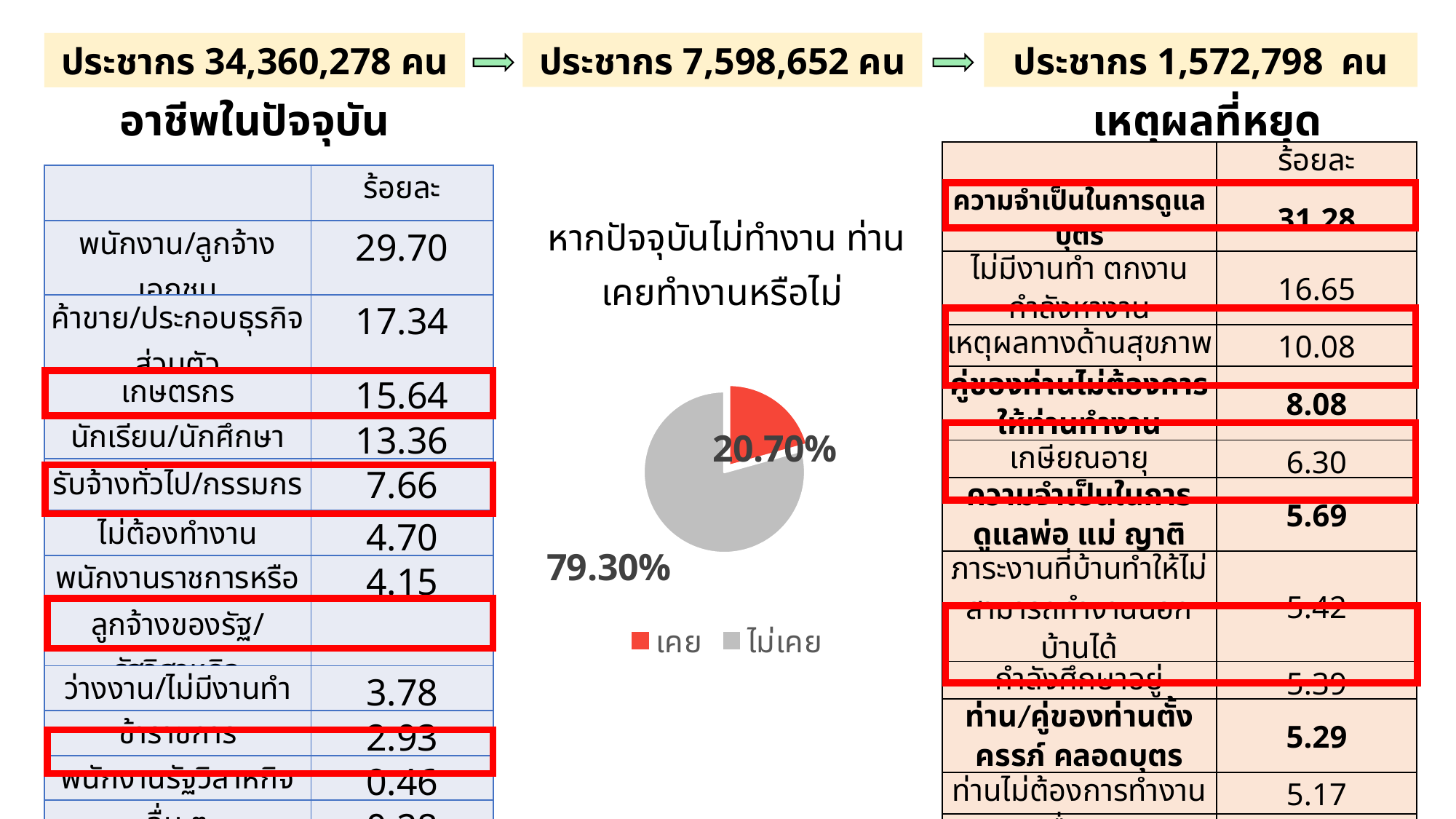
What colour is the เคย slice in the pie chart? red In the pie chart, which is larger, เคย or ไม่เคย? ไม่เคย How many entries does the pie chart's legend list? 2 In the pie chart, what percentage is shown for ไม่เคย? 79.30% In the pie chart, what is the difference between the ไม่เคย share and the เคย share? 58.60% How many slices does the pie chart have? 2 Which slice of the pie chart is the largest? ไม่เคย What is the title shown above the pie chart? หากปัจจุบันไม่ทำงาน ท่านเคยทำงานหรือไม่ What share of the pie does the เคย slice represent? 20.70% What kind of chart is shown in the middle of the slide? pie chart In the pie chart, what percentage is shown for เคย? 20.70% Which slice of the pie chart is the smallest? เคย